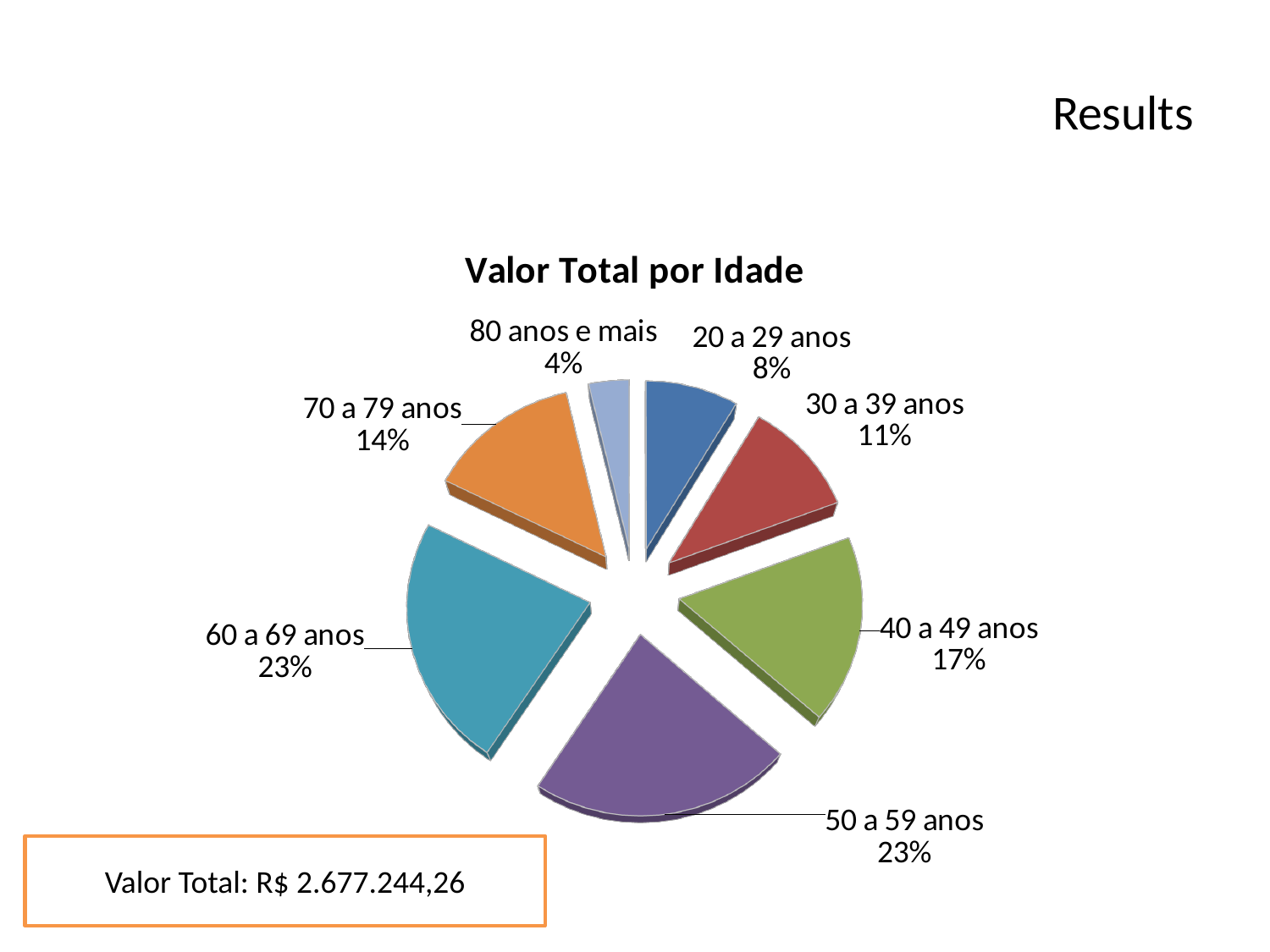
Which is larger, the share for "30 a 39 anos" or the share for "40 a 49 anos"? 40 a 49 anos What percentage is shown for "20 a 29 anos"? 8% What is the "Valor Total" stated in the box below the chart? R$ 2.677.244,26 What type of chart is shown on the slide? pie chart What share of the pie does "80 anos e mais" represent? 4% What is the difference in percentage points between the "40 a 49 anos" slice and the "30 a 39 anos" slice? 6 percentage points How many age categories are shown in the pie chart? 7 What percentage is shown for "60 a 69 anos"? 23% What percentage is shown for "70 a 79 anos"? 14% Which age category has the smallest share of the pie? 80 anos e mais What share of the pie does the "40 a 49 anos" slice represent? 17% What is the title of the chart? Valor Total por Idade